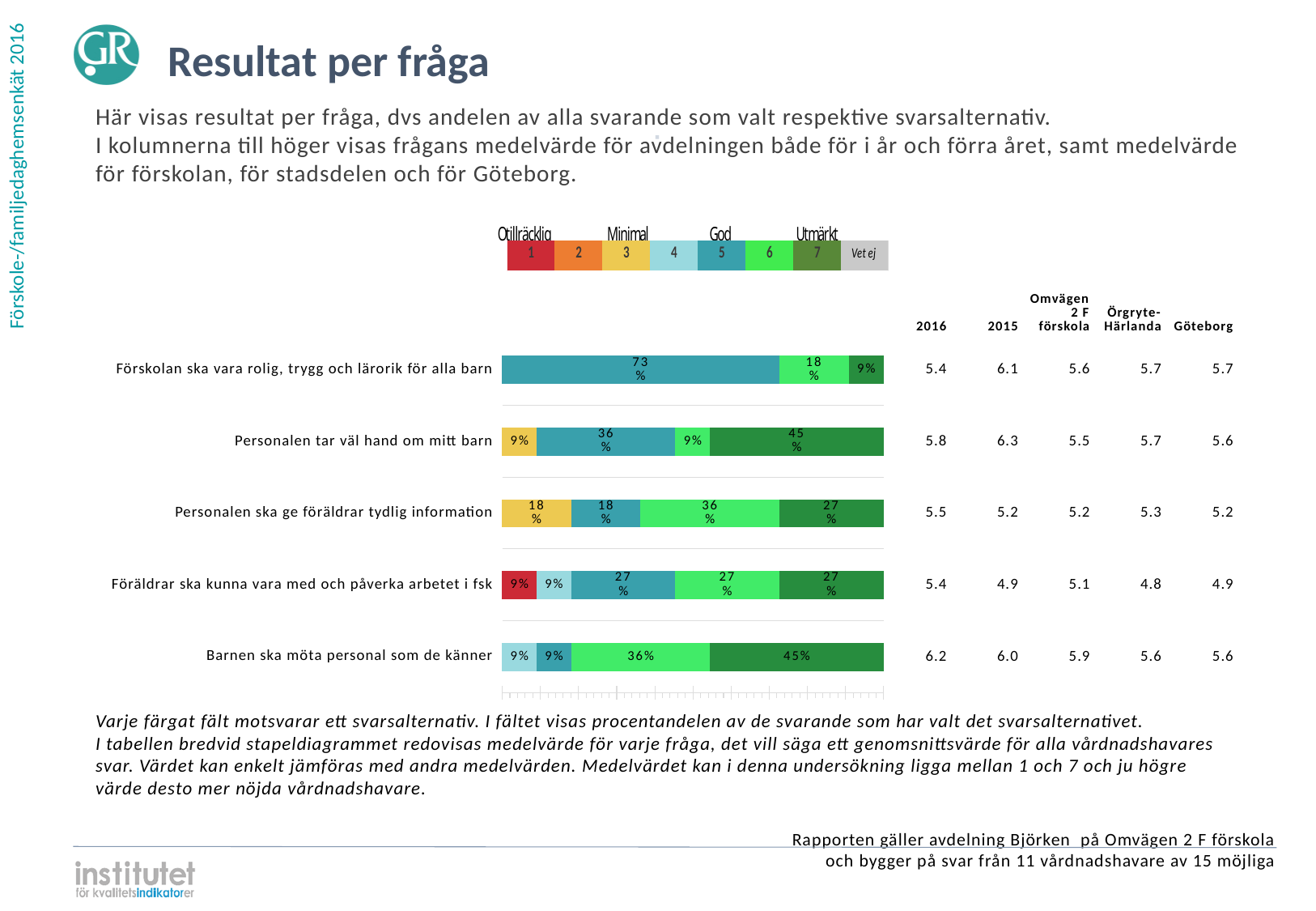
How many entries does the colour legend above the chart list? 8 What is the 2016 mean value shown for 'Barnen ska möta personal som de känner'? 6.2 Which bar contains the single largest segment in the chart? Förskolan ska vara rolig, trygg och lärorik för alla barn What percentage is shown for the largest segment of the bar 'Förskolan ska vara rolig, trygg och lärorik för alla barn'? 73% What label does the legend give to the value 7? Utmärkt What percentage of respondents chose 1 (Otillräcklig, red) for 'Föräldrar ska kunna vara med och påverka arbetet i fsk'? 9% How many questions (categories) are plotted as bars in the chart? 5 What percentage of respondents chose 7 (Utmärkt, dark green) for 'Personalen tar väl hand om mitt barn'? 45% Which has a larger dark green (7) segment: 'Barnen ska möta personal som de känner' or 'Personalen ska ge föräldrar tydlig information'? Barnen ska möta personal som de känner What kind of chart is shown on the slide? bar chart What percentage of respondents chose 6 (light green) for 'Personalen ska ge föräldrar tydlig information'? 36% For 'Barnen ska möta personal som de känner', what is the difference between the dark green (7) segment and the light green (6) segment? 9%